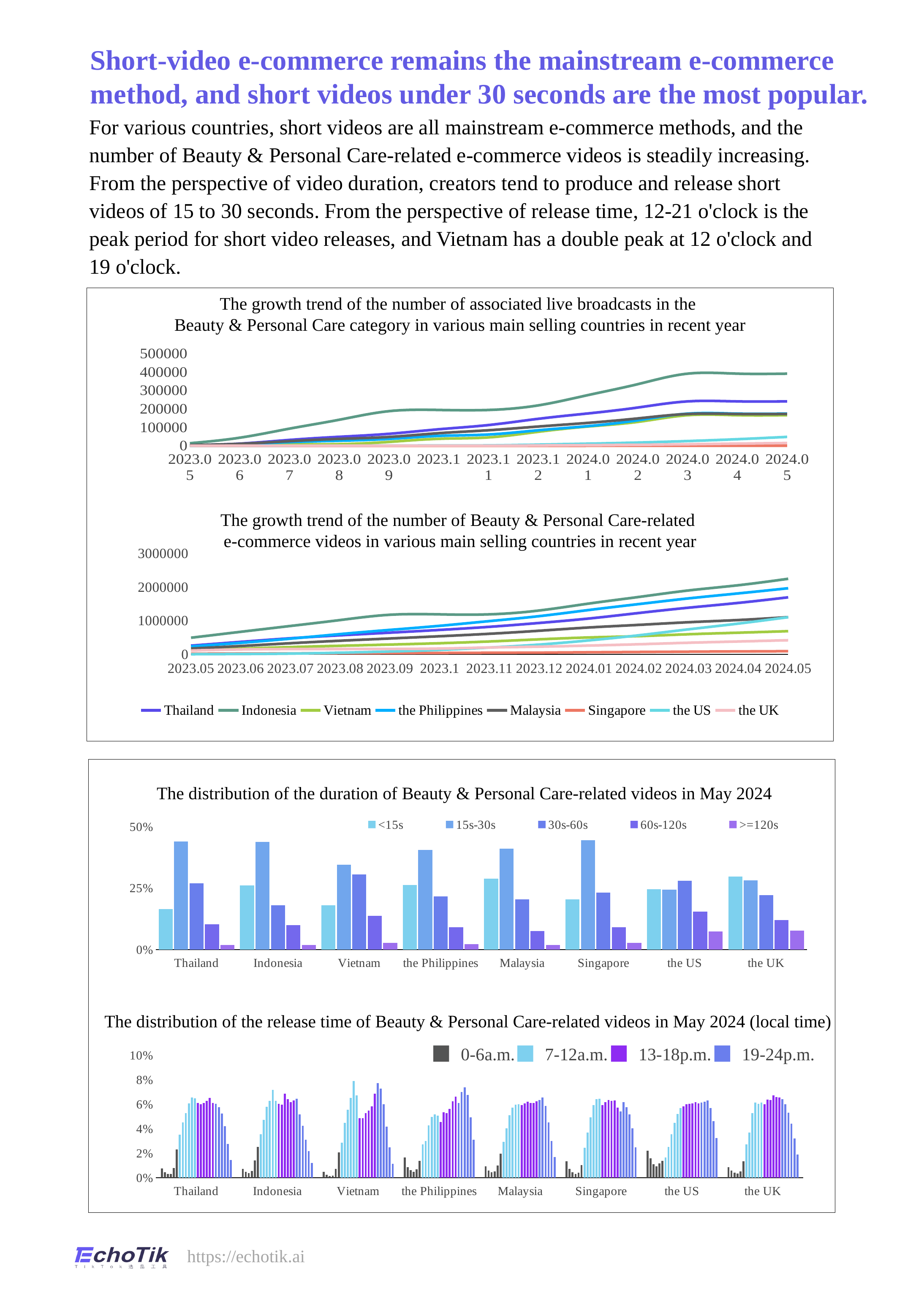
In the chart titled 'The growth trend of the number of associated live broadcasts in the Beauty & Personal Care category in various main selling countries in recent year', is the value for Indonesia at 2024.05 greater or less than 300000? greater How many series does the legend of the chart titled 'The distribution of the duration of Beauty & Personal Care-related videos in May 2024' list? 5 In the chart titled 'The distribution of the duration of Beauty & Personal Care-related videos in May 2024', which is larger for Thailand: the 15s-30s value or the 30s-60s value? 15s-30s How many time points are shown on the x axis of the chart titled 'The growth trend of the number of Beauty & Personal Care-related e-commerce videos in various main selling countries in recent year'? 13 What kind of chart is 'The distribution of the duration of Beauty & Personal Care-related videos in May 2024'? bar chart In the chart titled 'The growth trend of the number of Beauty & Personal Care-related e-commerce videos in various main selling countries in recent year', is the value for Thailand at 2024.05 greater or less than 1000000? greater In the chart titled 'The growth trend of the number of associated live broadcasts in the Beauty & Personal Care category in various main selling countries in recent year', which country has the highest value at 2024.05? Indonesia In the chart titled 'The distribution of the duration of Beauty & Personal Care-related videos in May 2024', is the 15s-30s value for Thailand greater or less than 25%? greater In the chart titled 'The growth trend of the number of Beauty & Personal Care-related e-commerce videos in various main selling countries in recent year', does the value for Indonesia rise or fall from 2023.05 to 2024.05? rise In the chart titled 'The growth trend of the number of Beauty & Personal Care-related e-commerce videos in various main selling countries in recent year', which country has the lowest value at 2024.05? Singapore How many series does the legend of the chart titled 'The distribution of the release time of Beauty & Personal Care-related videos in May 2024 (local time)' list? 4 How many countries does the legend of the two line charts list? 8